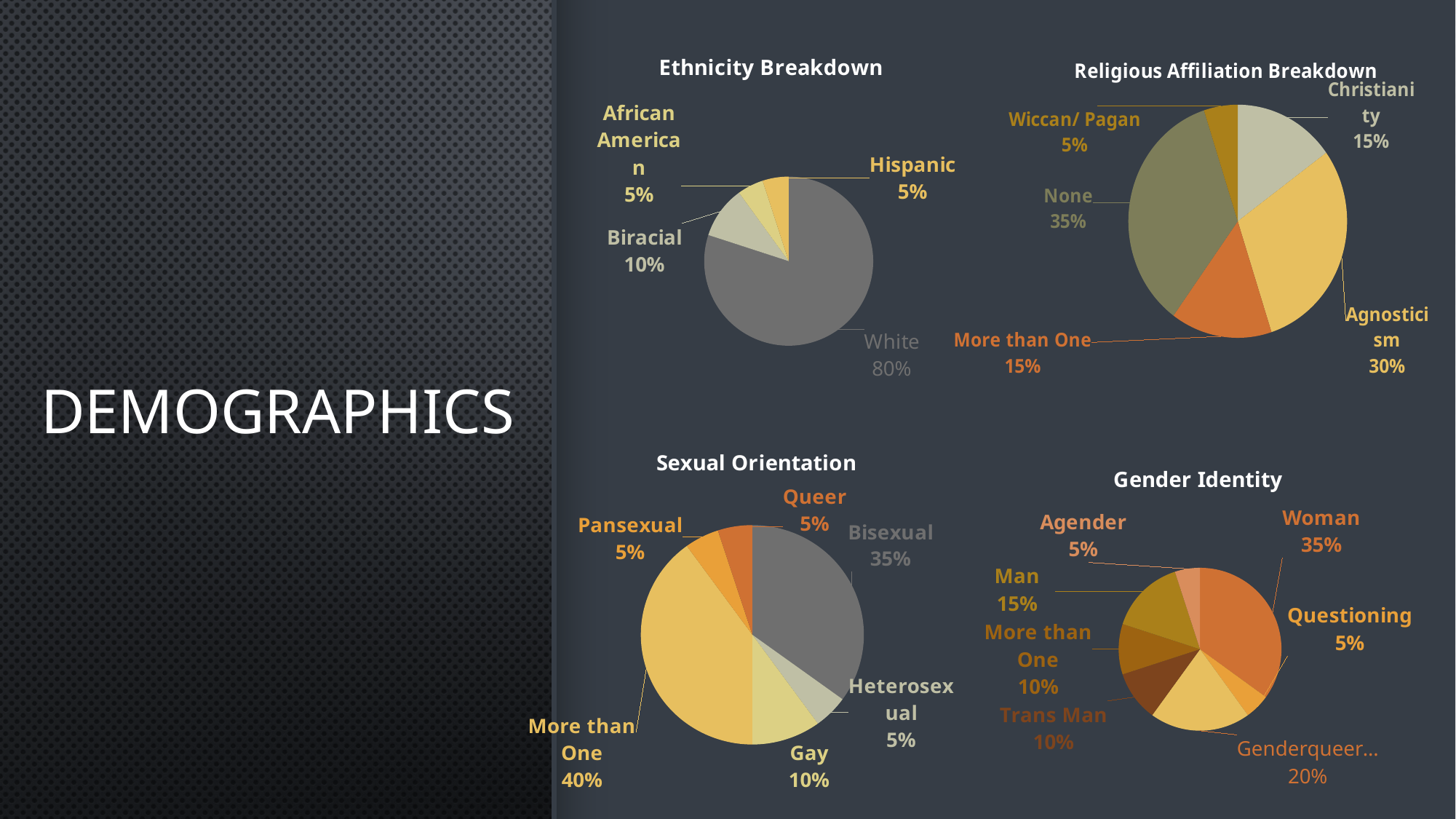
In the Ethnicity Breakdown chart, how many categories are shown? 4 In the Sexual Orientation chart, which is larger, More than One or Bisexual? More than One In the Religious Affiliation Breakdown chart, what is the difference between None and Christianity? 20% In the Gender Identity chart, what is the difference between Genderqueer and Man? 5% In the Sexual Orientation chart, how many categories are shown? 6 In the Religious Affiliation Breakdown chart, what percentage is Agnosticism? 30% What type of chart is the Gender Identity chart? Pie chart In the Religious Affiliation Breakdown chart, which category has the largest share? None In the Ethnicity Breakdown chart, what percentage is White? 80% In the Gender Identity chart, what percentage is Woman? 35% In the Sexual Orientation chart, what percentage is Bisexual? 35% In the Ethnicity Breakdown chart, which category has the largest share? White